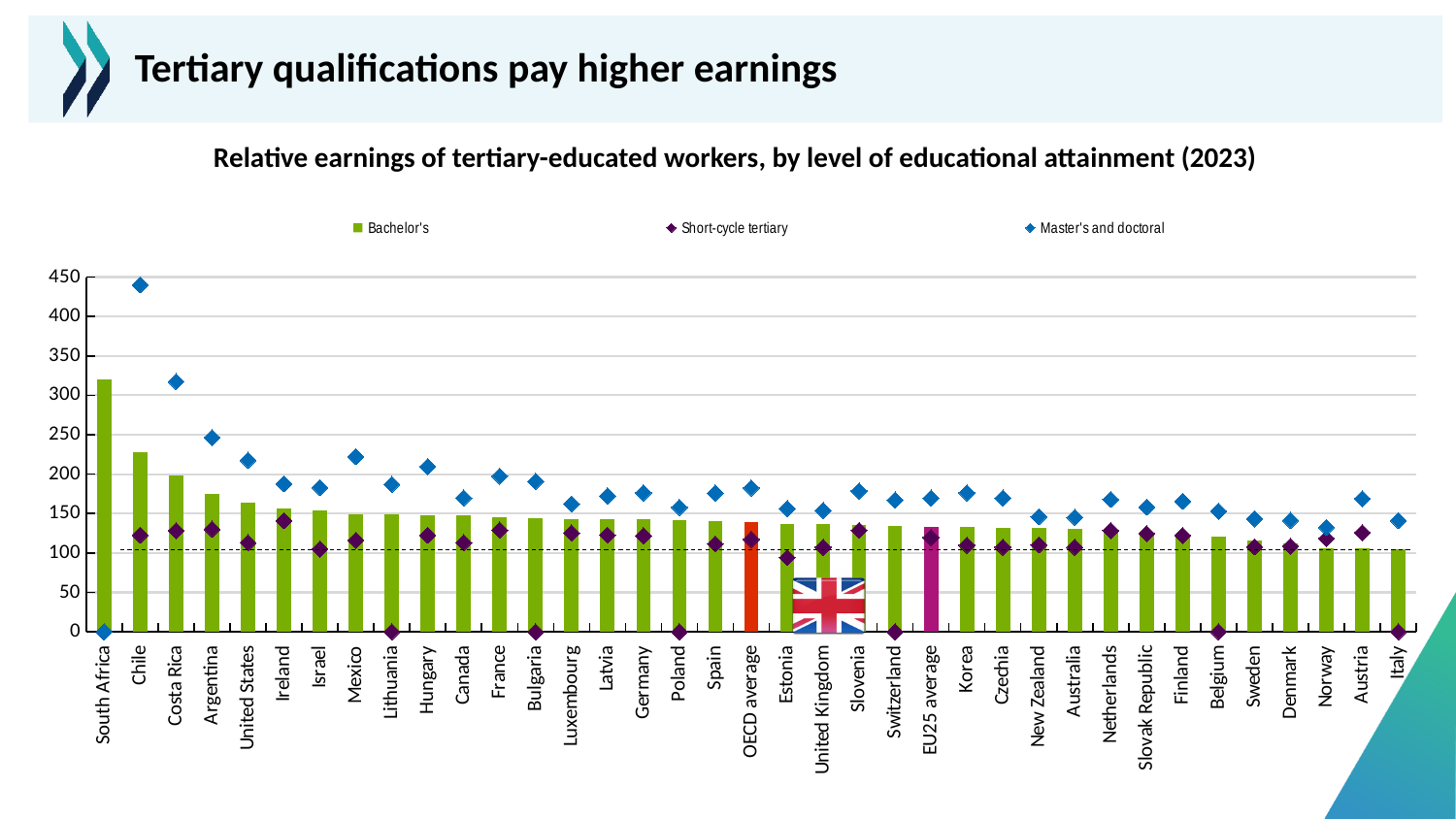
Is the Bachelor's value for South Africa greater or less than 300? greater Which category has the highest Master's and doctoral value? Chile Which has the larger Bachelor's value, Chile or Costa Rica? Chile How many countries or averages are shown along the x axis? 37 How many series does the legend list? 3 What are the three series named in the legend? Bachelor's, Short-cycle tertiary, Master's and doctoral Is the Master's and doctoral value for Chile greater or less than 400? greater What kind of chart is shown on the slide? Bar chart with diamond markers Do the Bachelor's values generally rise or fall from left to right along the x axis? fall Is the Bachelor's value for Italy greater or less than 150? less Which category has the highest Bachelor's value? South Africa